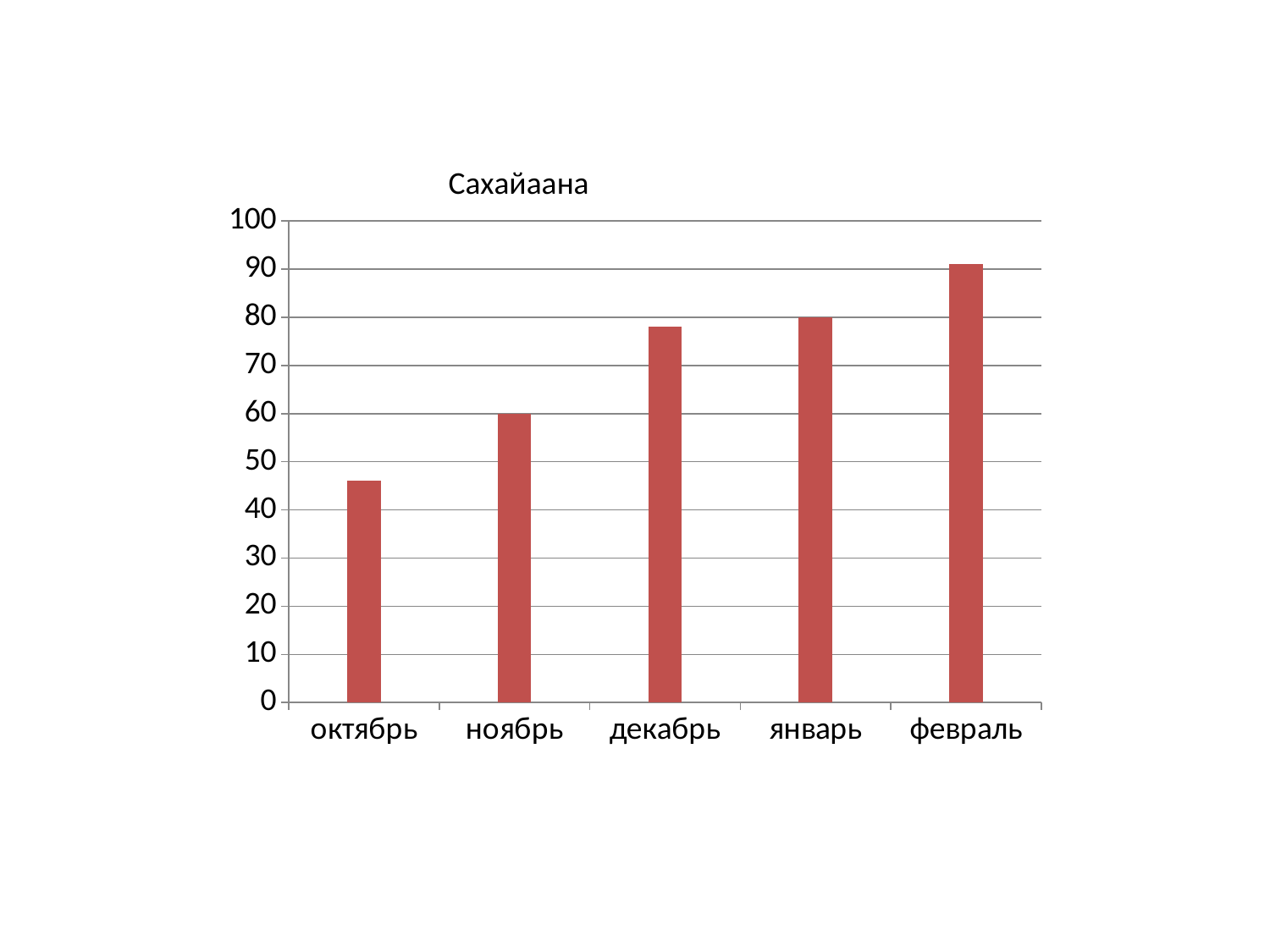
What is the value for январь? 80 What is the title of the chart? Сахайаана Which is larger, the value for декабрь or the value for ноябрь? декабрь What is the difference between the values for январь and ноябрь? 20 What kind of chart is shown on the slide? bar chart Do the values rise or fall from октябрь to февраль? rise Is the value for октябрь greater or less than 50? less Which month has the highest value? февраль How many categories are shown on the x axis of the chart? 5 What is the value for ноябрь? 60 Which month has the lowest value? октябрь Is the value for февраль greater or less than 80? greater